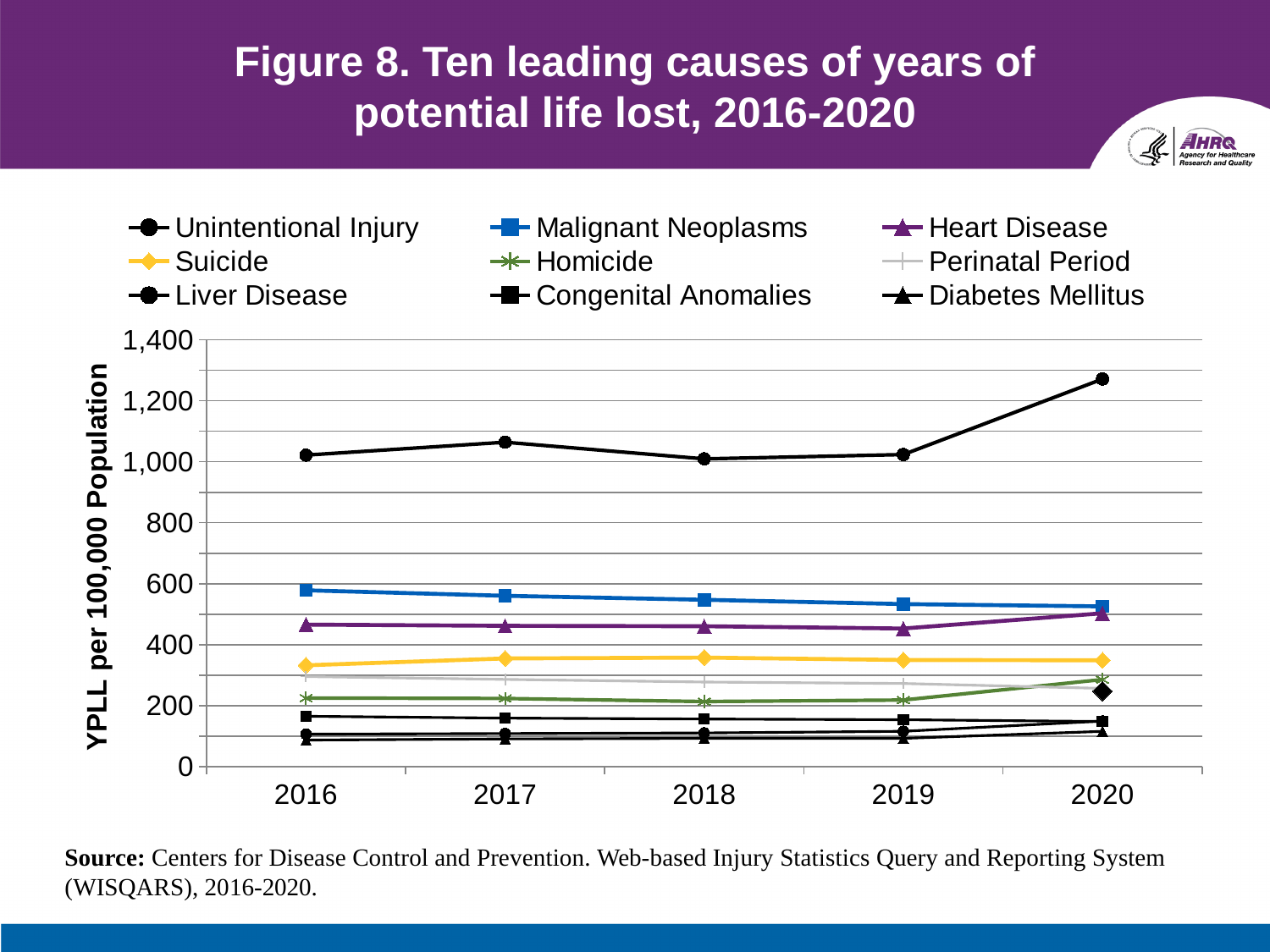
What kind of chart is shown on the slide? Line chart Is the value for Homicide in 2020 greater or less than 200? greater What is the label on the y axis? YPLL per 100,000 Population Is the value for Unintentional Injury in 2020 greater or less than 1,200? greater Which cause has the highest YPLL per 100,000 population in 2020? Unintentional Injury Is the value for Heart Disease in 2016 greater or less than 400? greater In 2018, which is larger: Heart Disease or Suicide? Heart Disease Does the Unintentional Injury line rise or fall from 2019 to 2020? rise How many series does the legend list? 9 How many years are plotted along the x axis? 5 Does the Malignant Neoplasms line rise or fall from 2016 to 2020? fall